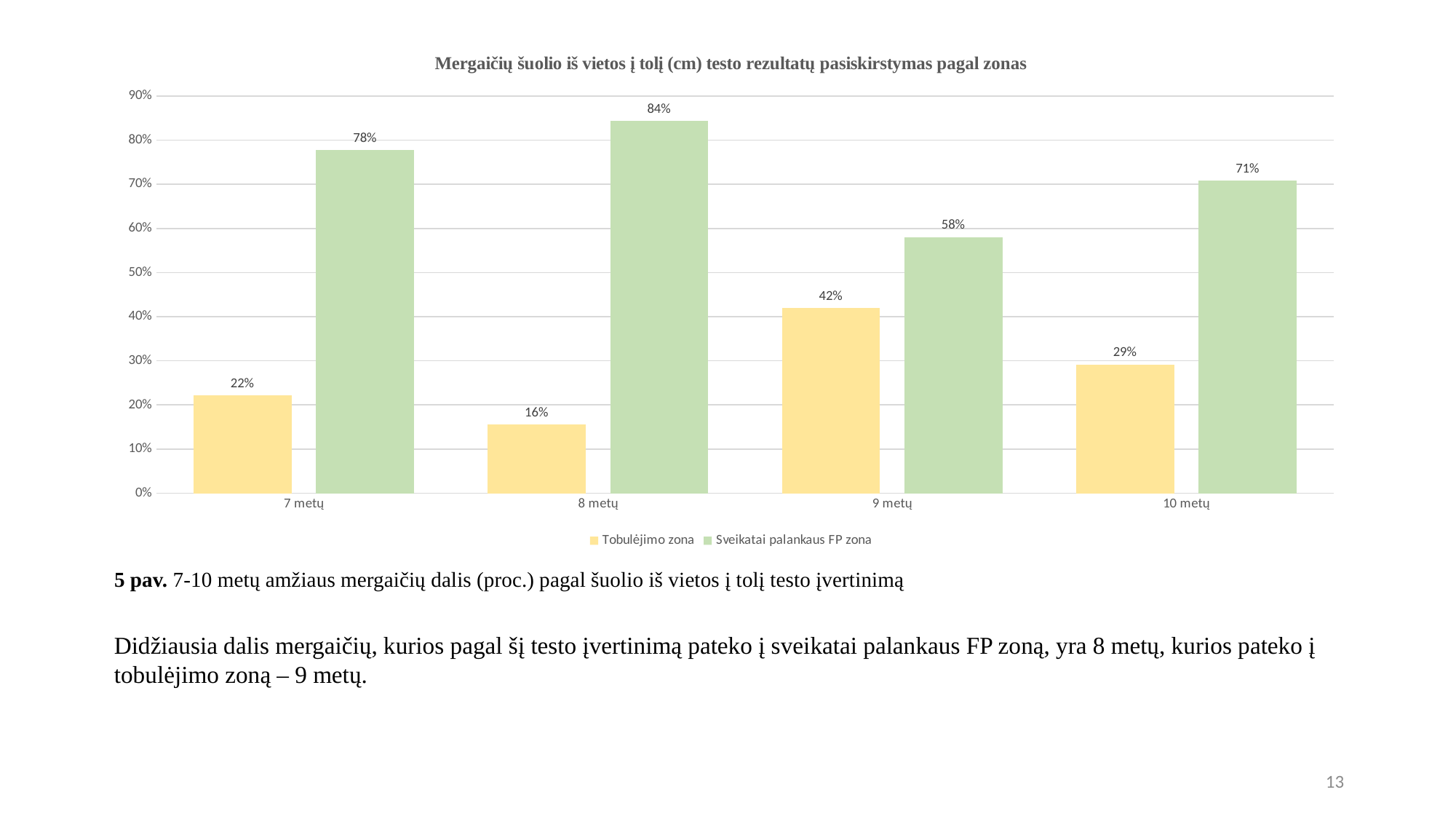
Which is larger: the Tobulėjimo zona value for 9 metų or for 10 metų? 9 metų What is the value for Tobulėjimo zona for 10 metų? 29% Which age group has the highest value for Sveikatai palankaus FP zona? 8 metų How many series does the legend list? 2 Which age group has the lowest value for Tobulėjimo zona? 8 metų What is the difference between the Sveikatai palankaus FP zona value and the Tobulėjimo zona value for 9 metų? 16% What is the value for Tobulėjimo zona for 7 metų? 22% What is the value for Sveikatai palankaus FP zona for 8 metų? 84% Which colour represents Sveikatai palankaus FP zona in the chart? Green How many age groups are shown on the x axis? 4 What kind of chart is shown on the slide? Bar chart Is the Sveikatai palankaus FP zona value for 10 metų greater or less than 60%? greater